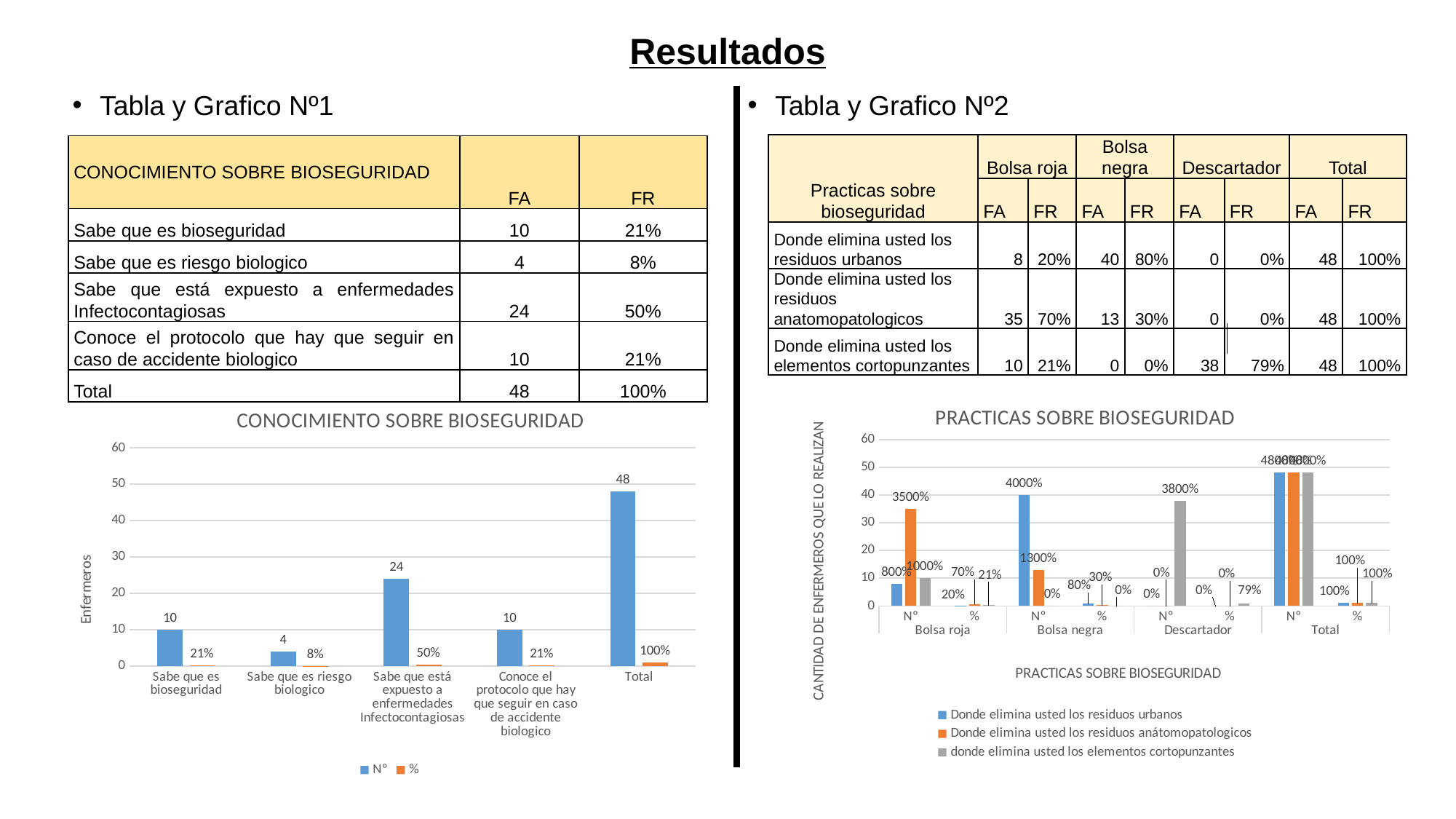
In the CONOCIMIENTO SOBRE BIOSEGURIDAD chart, what is the label of the vertical axis? Enfermeros In the CONOCIMIENTO SOBRE BIOSEGURIDAD chart, what is the N° value for 'Sabe que está expuesto a enfermedades Infectocontagiosas'? 24 In the CONOCIMIENTO SOBRE BIOSEGURIDAD chart, what is the % label for 'Sabe que es riesgo biologico'? 8% What kind of chart is the PRACTICAS SOBRE BIOSEGURIDAD chart? bar chart In the PRACTICAS SOBRE BIOSEGURIDAD chart, which is larger for Bolsa roja N°: the blue bar or the orange bar? the orange bar In the CONOCIMIENTO SOBRE BIOSEGURIDAD chart, which category has the lowest N° value? Sabe que es riesgo biologico In the CONOCIMIENTO SOBRE BIOSEGURIDAD chart, what is the difference between the N° value for Total and the N° value for 'Sabe que está expuesto a enfermedades Infectocontagiosas'? 24 In the PRACTICAS SOBRE BIOSEGURIDAD chart, what is the data label on the grey bar for Descartador N°? 3800% In the PRACTICAS SOBRE BIOSEGURIDAD chart, is the blue bar for Bolsa negra N° greater or less than 30? greater In the CONOCIMIENTO SOBRE BIOSEGURIDAD chart, how many categories are shown on the x axis? 5 In the CONOCIMIENTO SOBRE BIOSEGURIDAD chart, how many series does the legend list? 2 In the PRACTICAS SOBRE BIOSEGURIDAD chart, how many series does the legend list? 3